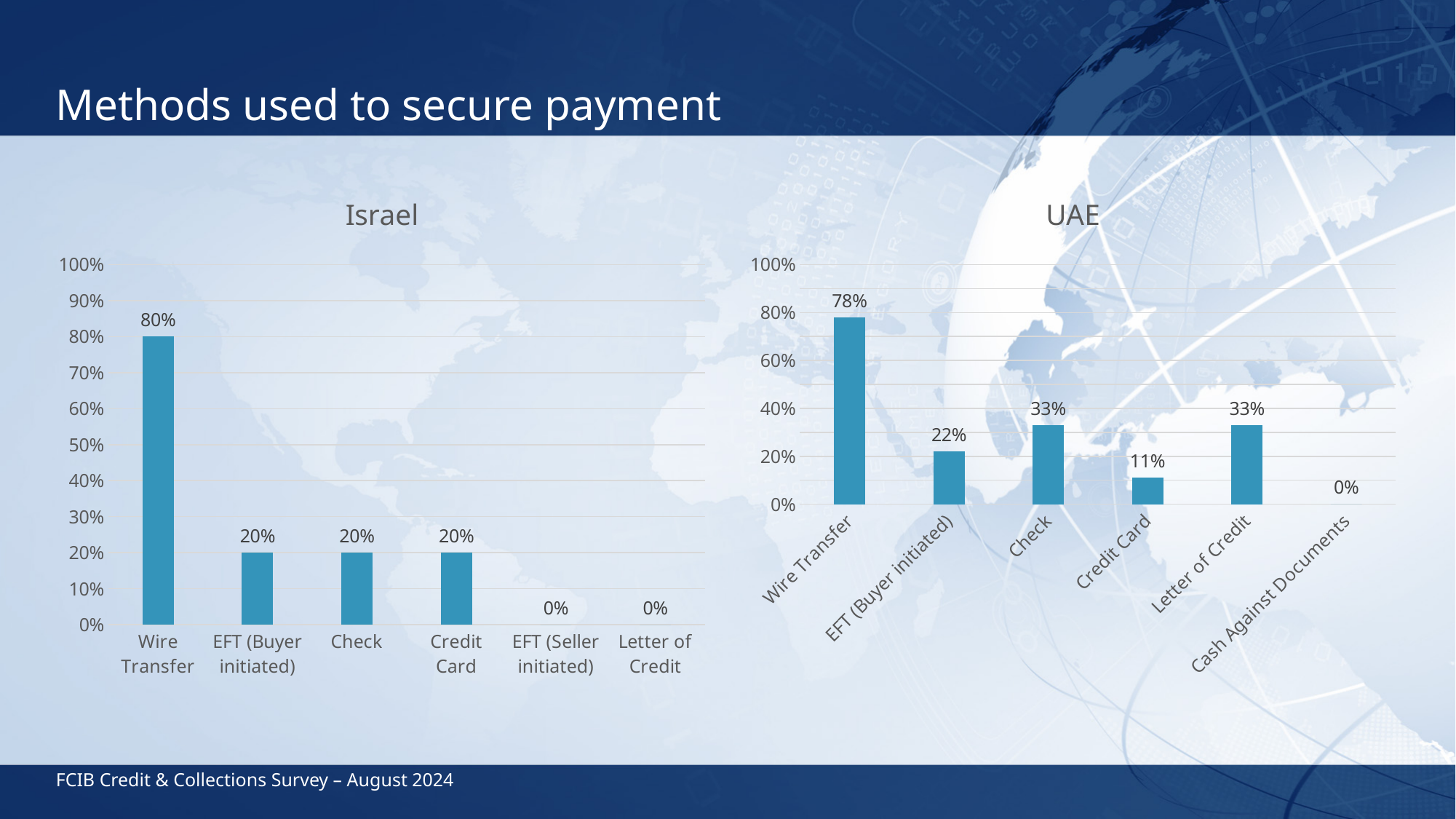
In the UAE chart, which category has the lowest value? Cash Against Documents In the UAE chart, what is the difference between Wire Transfer and Check? 45% In the UAE chart, what is the value for Credit Card? 11% In the UAE chart, which is larger, EFT (Buyer initiated) or Letter of Credit? Letter of Credit In the Israel chart, what is the value for Letter of Credit? 0% What kind of chart is the UAE chart? bar chart In the Israel chart, is the value for Wire Transfer greater or less than 50%? greater In the UAE chart, what is the value for EFT (Buyer initiated)? 22% In the Israel chart, which category has the highest value? Wire Transfer In the Israel chart, what is the value for Wire Transfer? 80% How many categories are shown in the Israel chart? 6 In the Israel chart, what is the difference between Wire Transfer and Credit Card? 60%